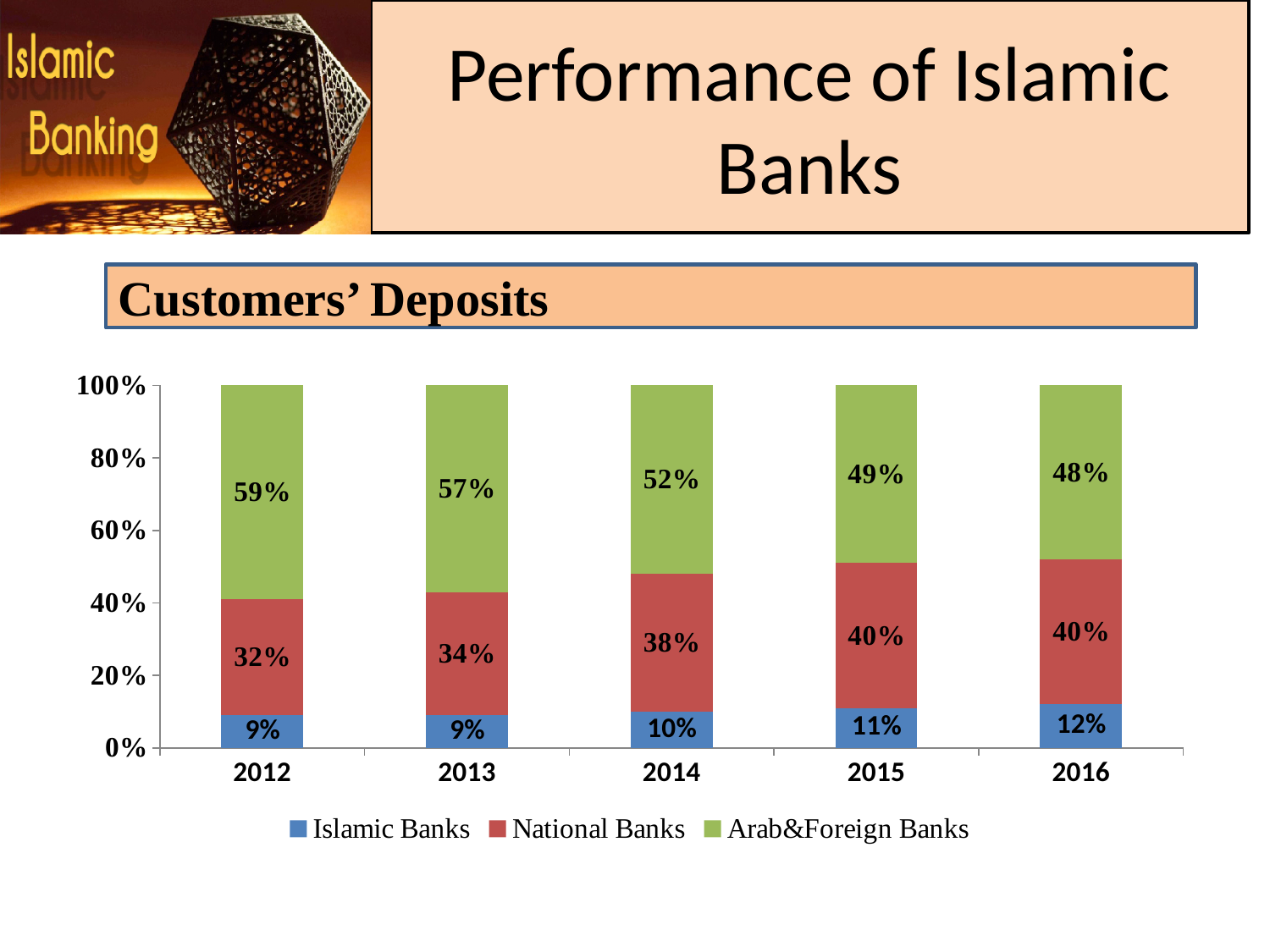
How many years are shown on the x axis of the chart? 5 In which year was the Arab&Foreign Banks share of customers' deposits lowest? 2016 Which was larger in 2015: the National Banks share or the Arab&Foreign Banks share? Arab&Foreign Banks What kind of chart is shown on the slide? Stacked bar chart What is the title of the chart? Customers' Deposits How many series does the legend list? 3 By how many percentage points did the Arab&Foreign Banks share fall from 2012 to 2016? 11% What share of customers' deposits did National Banks hold in 2014? 38% What share of customers' deposits did Arab&Foreign Banks hold in 2012? 59% What share of customers' deposits did Islamic Banks hold in 2016? 12% In which year was the Islamic Banks share of customers' deposits highest? 2016 Does the Islamic Banks share of customers' deposits rise or fall from 2012 to 2016? Rise